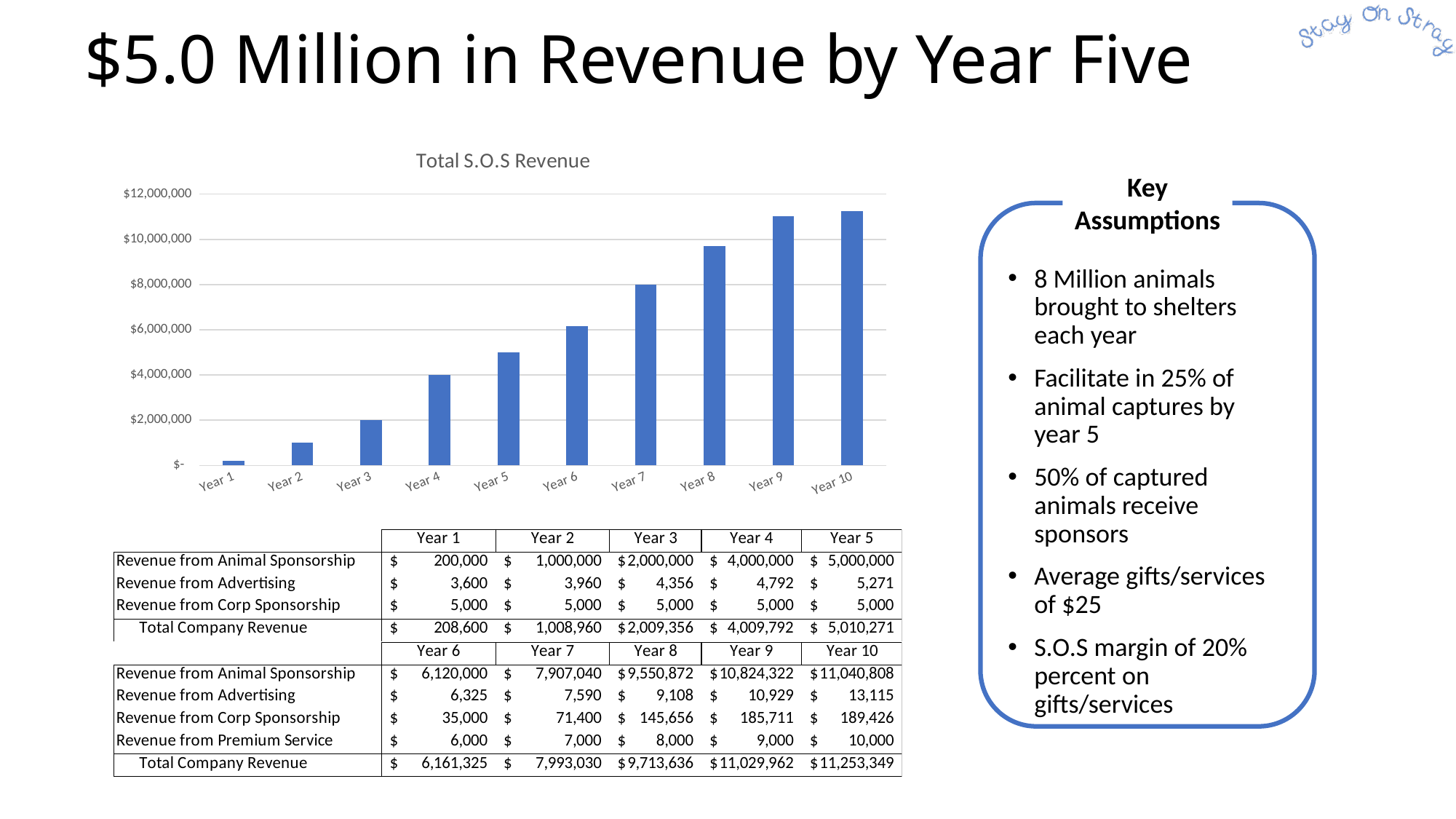
Which year has the lowest revenue in the chart? Year 1 Is the value for Year 8 greater or less than $10,000,000? less Is the value for Year 2 greater or less than $2,000,000? less Is the value for Year 1 greater or less than $2,000,000? less Do the revenue values rise or fall from Year 1 to Year 10 in the chart? rise Which is larger in the chart, the value for Year 8 or the value for Year 9? Year 9 How many years (categories) are shown on the x axis of the chart? 10 What kind of chart is shown on the slide? bar chart What is the title of the chart? Total S.O.S Revenue Which is larger in the chart, the value for Year 5 or the value for Year 6? Year 6